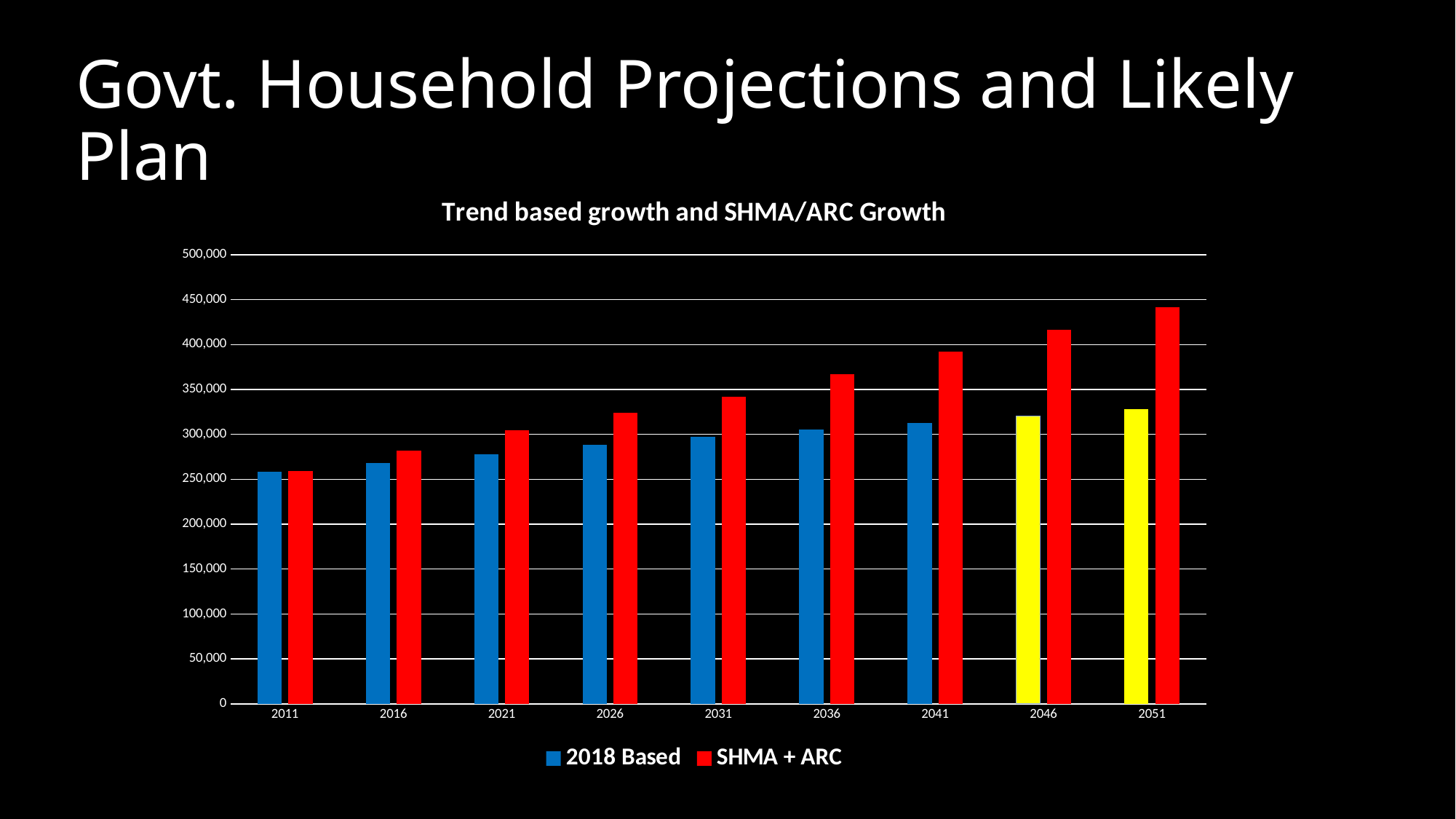
How many years are shown along the x axis? 9 For 2036, which series has the larger value, 2018 Based or SHMA + ARC? SHMA + ARC Is the 2018 Based value for 2011 greater or less than 250,000? greater How many series does the legend list? 2 In which year is the 2018 Based value lowest? 2011 What kind of chart is shown on the slide? bar chart What is the title of the chart? Trend based growth and SHMA/ARC Growth Is the SHMA + ARC value for 2051 greater or less than 400,000? greater Is the 2018 Based value for 2041 greater or less than 350,000? less In which year is the SHMA + ARC value highest? 2051 Do the SHMA + ARC values rise or fall from 2011 to 2051? rise What colour represents the SHMA + ARC series in the legend? red